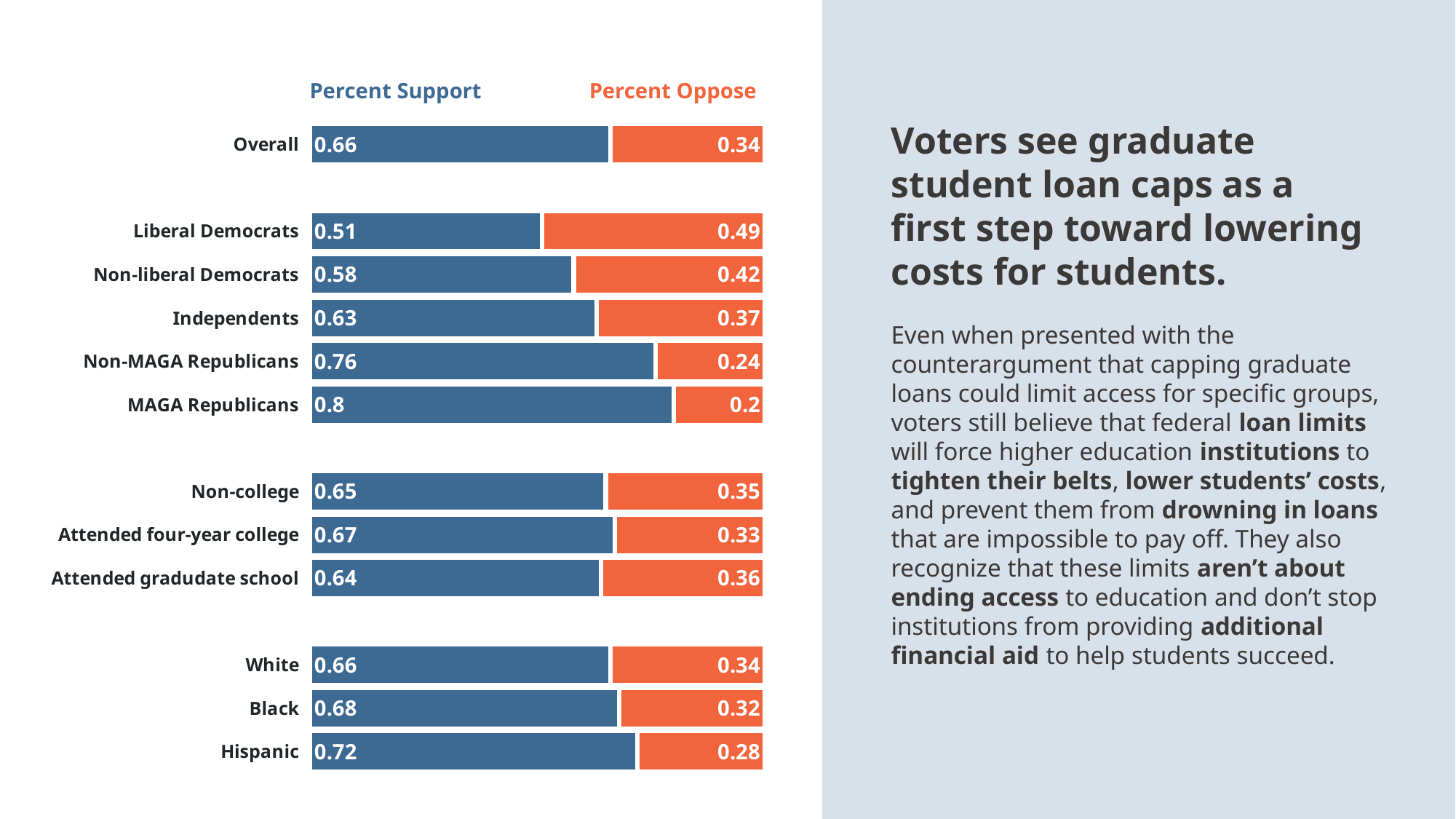
What is the total of the Percent Support and Percent Oppose values for the Overall bar? 1 What kind of chart is shown on the slide? Stacked bar chart Which category has the highest Percent Support? MAGA Republicans What colour represents Percent Oppose in the chart? Orange Which has a higher Percent Support, Black or White respondents? Black What is the difference in Percent Support between Non-MAGA Republicans and Independents? 0.13 How many series does the chart show? 2 What is the Percent Support value for MAGA Republicans? 0.8 How many categories are shown in the chart? 12 What is the Percent Support value for Hispanic respondents? 0.72 What is the Percent Oppose value for Liberal Democrats? 0.49 Which category has the lowest Percent Support? Liberal Democrats